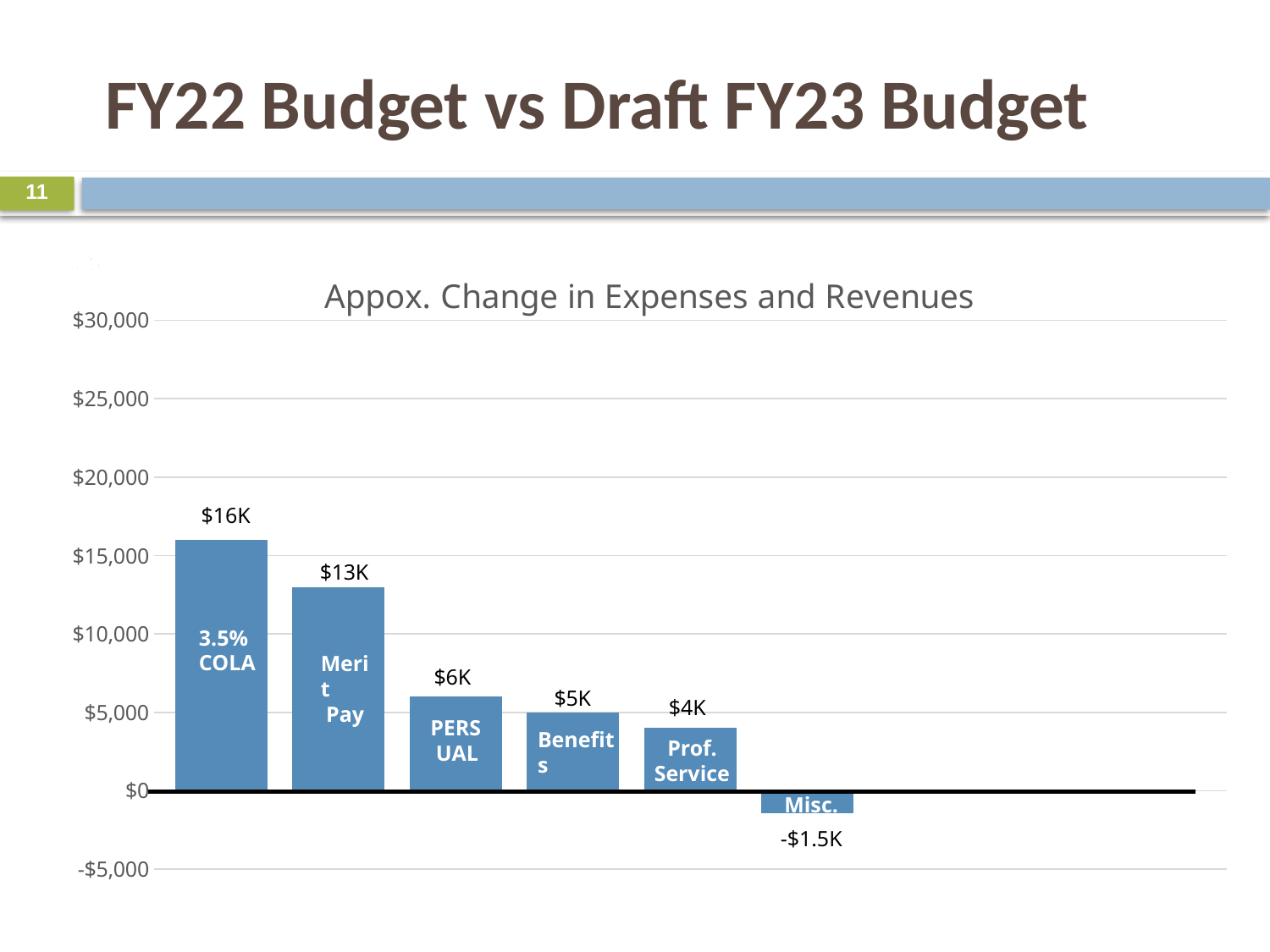
What is the value for PERS UAL? $6K What is the title of the chart? Appox. Change in Expenses and Revenues What is the value for 3.5% COLA? $16K Is the value for Merit Pay greater or less than $10,000? greater What is the difference between the values for 3.5% COLA and Merit Pay? $3K Which is larger, the value for Benefits or the value for Prof. Service? Benefits Which category has the highest value? 3.5% COLA What is the value for Merit Pay? $13K What is the value for Misc.? -$1.5K Which category has the lowest value? Misc. How many categories are shown in the chart? 6 What kind of chart is shown on the slide? bar chart